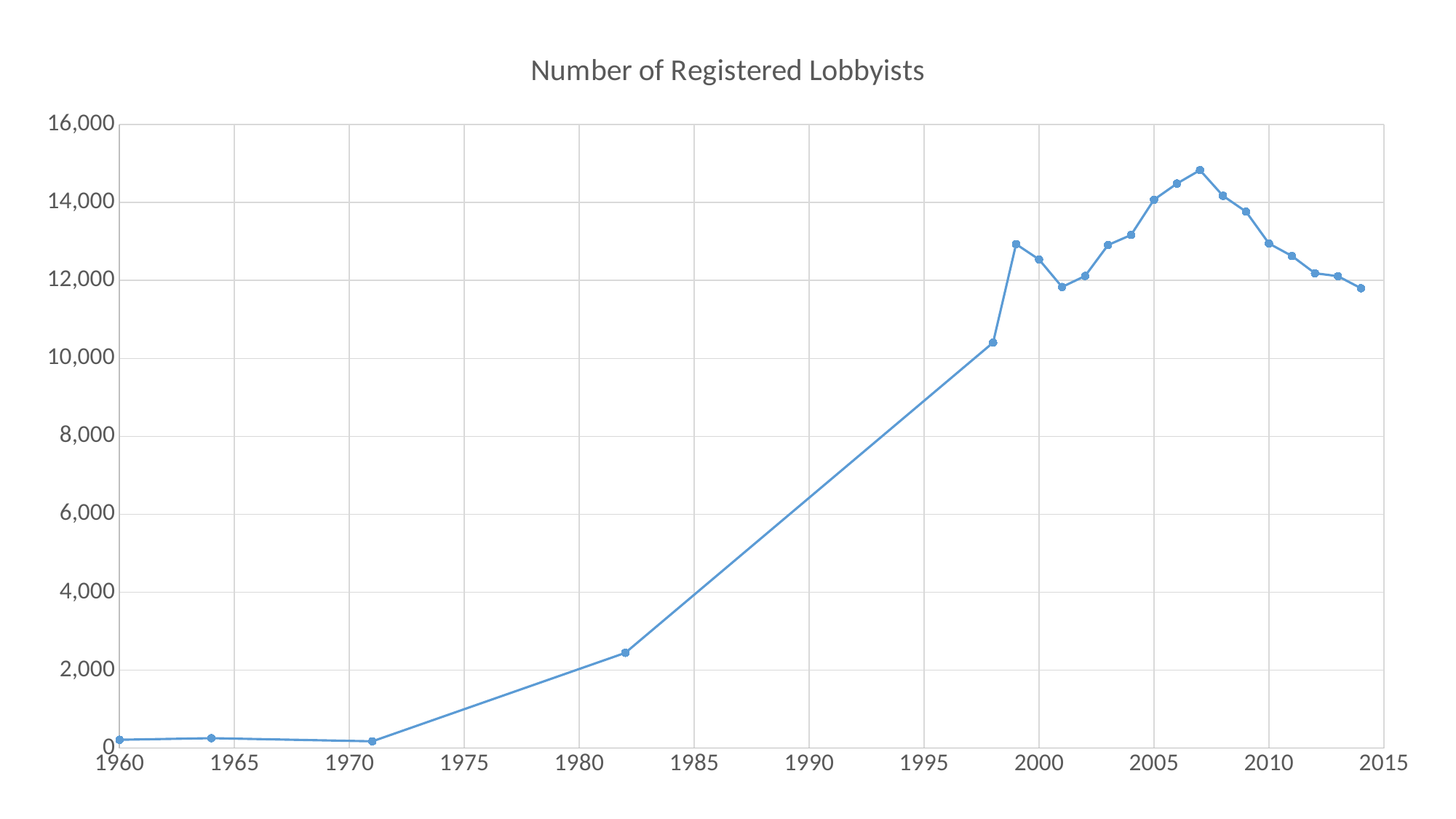
Is the value for 2007 greater or less than 14,000? greater Which year has the higher value, 1999 or 2000? 1999 What kind of chart is shown on the slide? line chart In which year does the number of registered lobbyists reach its highest point? 2007 Is the value for 1982 greater or less than 2,000? greater Does the number of registered lobbyists rise or fall between 2007 and 2014? fall What is the title of the chart? Number of Registered Lobbyists Is the value for 2014 greater or less than 12,000? less Does the number of registered lobbyists rise or fall between 1971 and 1999? rise How many data points are plotted on the line? 21